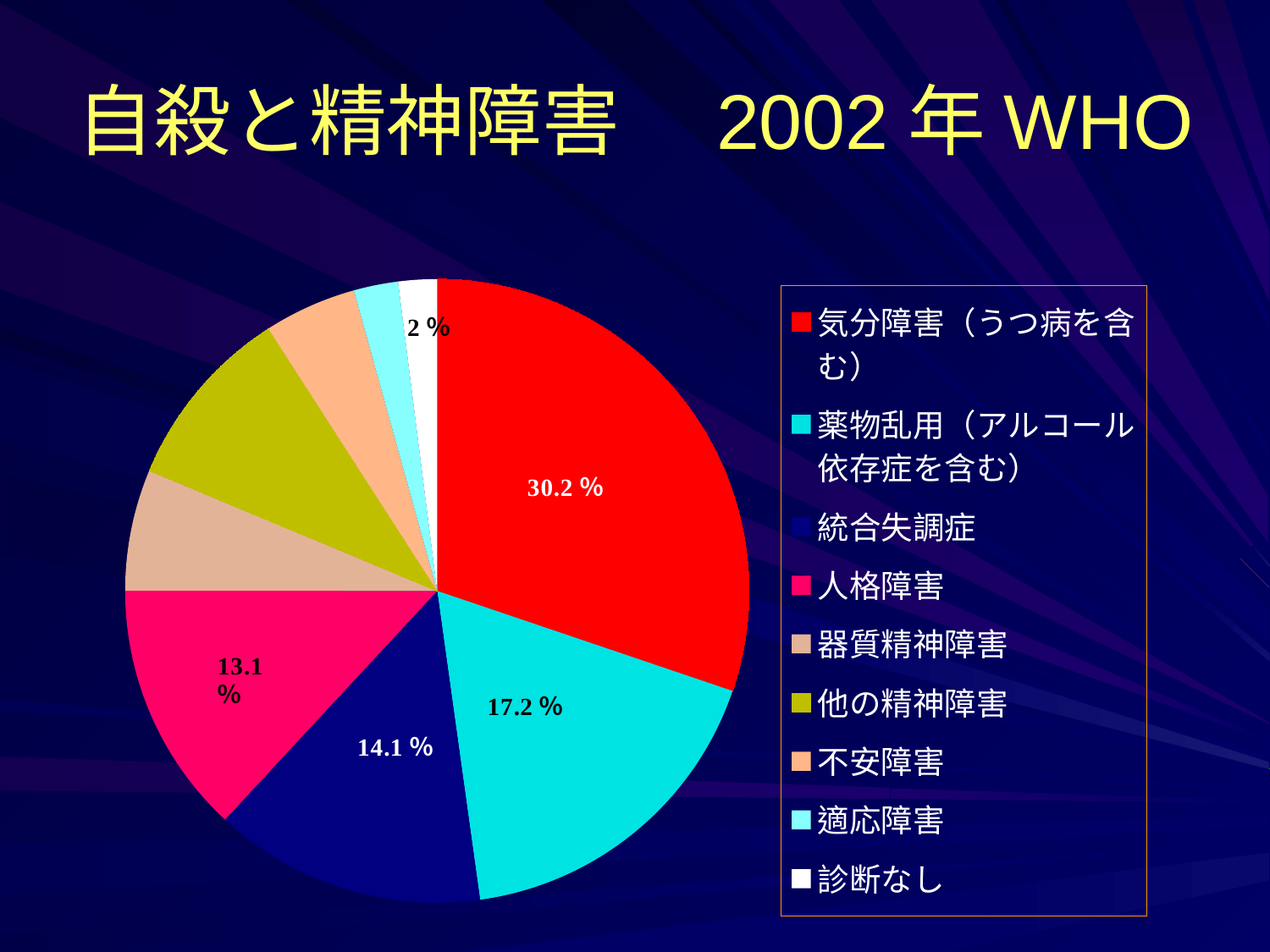
Which is larger, the slice for 統合失調症 or the slice for 人格障害? 統合失調症 What percentage is shown for 診断なし? 2% Which category has the largest slice of the pie? 気分障害（うつ病を含む） What percentage is shown for 気分障害（うつ病を含む）? 30.2% What colour is the slice for 他の精神障害? olive green What percentage is shown for 薬物乱用（アルコール依存症を含む）? 17.2% What percentage is shown for 人格障害? 13.1% What is the difference between the percentages for 気分障害（うつ病を含む） and 薬物乱用（アルコール依存症を含む）? 13.0% How many categories does the legend list? 9 What percentage is shown for 統合失調症? 14.1% What kind of chart is shown on the slide? pie chart Which category has the smallest slice of the pie? 診断なし